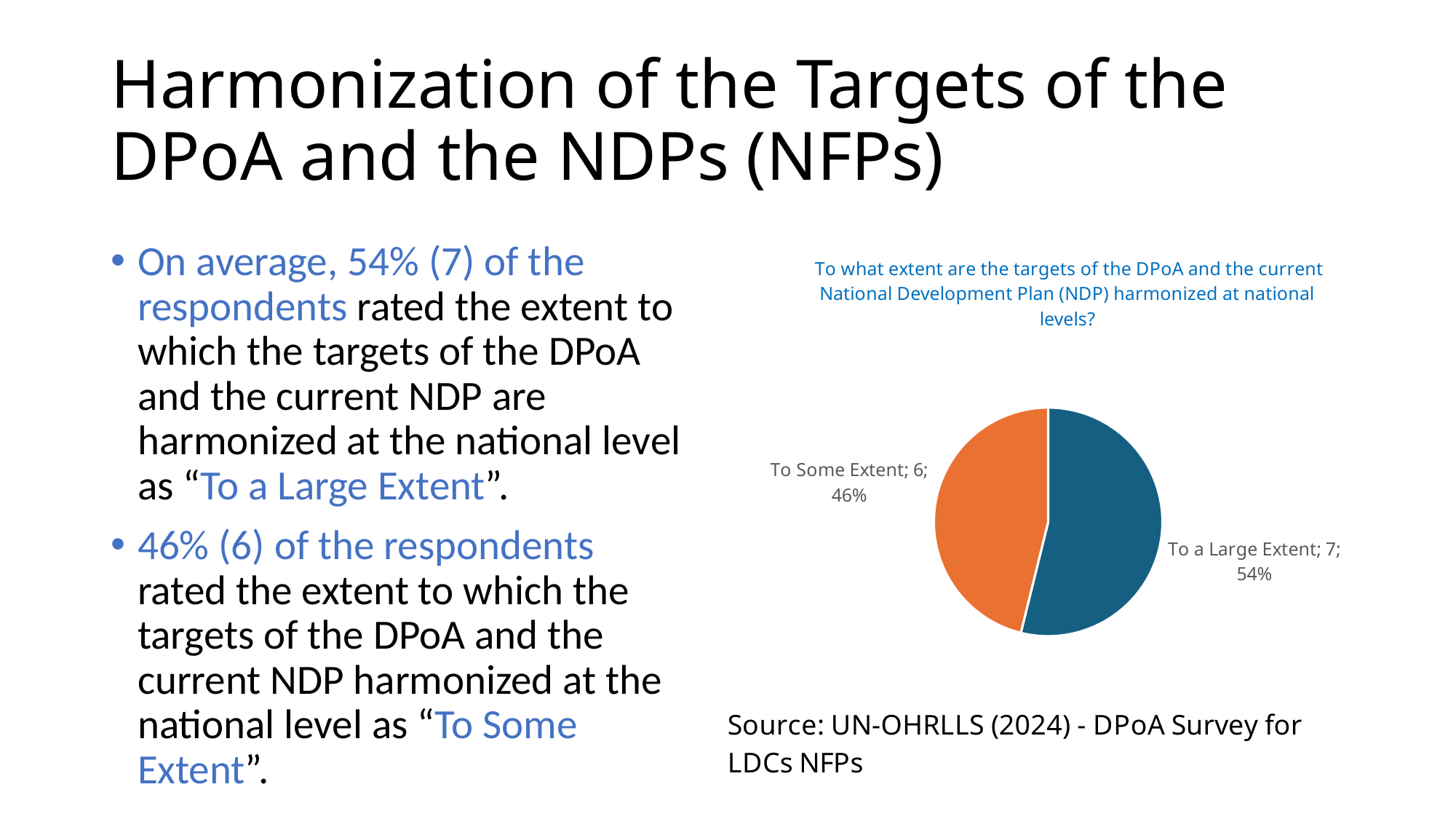
How many respondents rated the harmonization as "To a Large Extent"? 7 What share of the pie does "To a Large Extent" represent? 54% Which has more respondents, "To a Large Extent" or "To Some Extent"? To a Large Extent Which category has the smallest slice of the pie? To Some Extent What kind of chart is shown on the slide? pie chart How many categories are shown in the pie chart? 2 What colour is the "To Some Extent" slice? orange What share of the pie does "To Some Extent" represent? 46% Which category has the largest slice of the pie? To a Large Extent How many respondents rated the harmonization as "To Some Extent"? 6 What is the total number of respondents shown in the pie chart? 13 What is the difference in the number of respondents between "To a Large Extent" and "To Some Extent"? 1